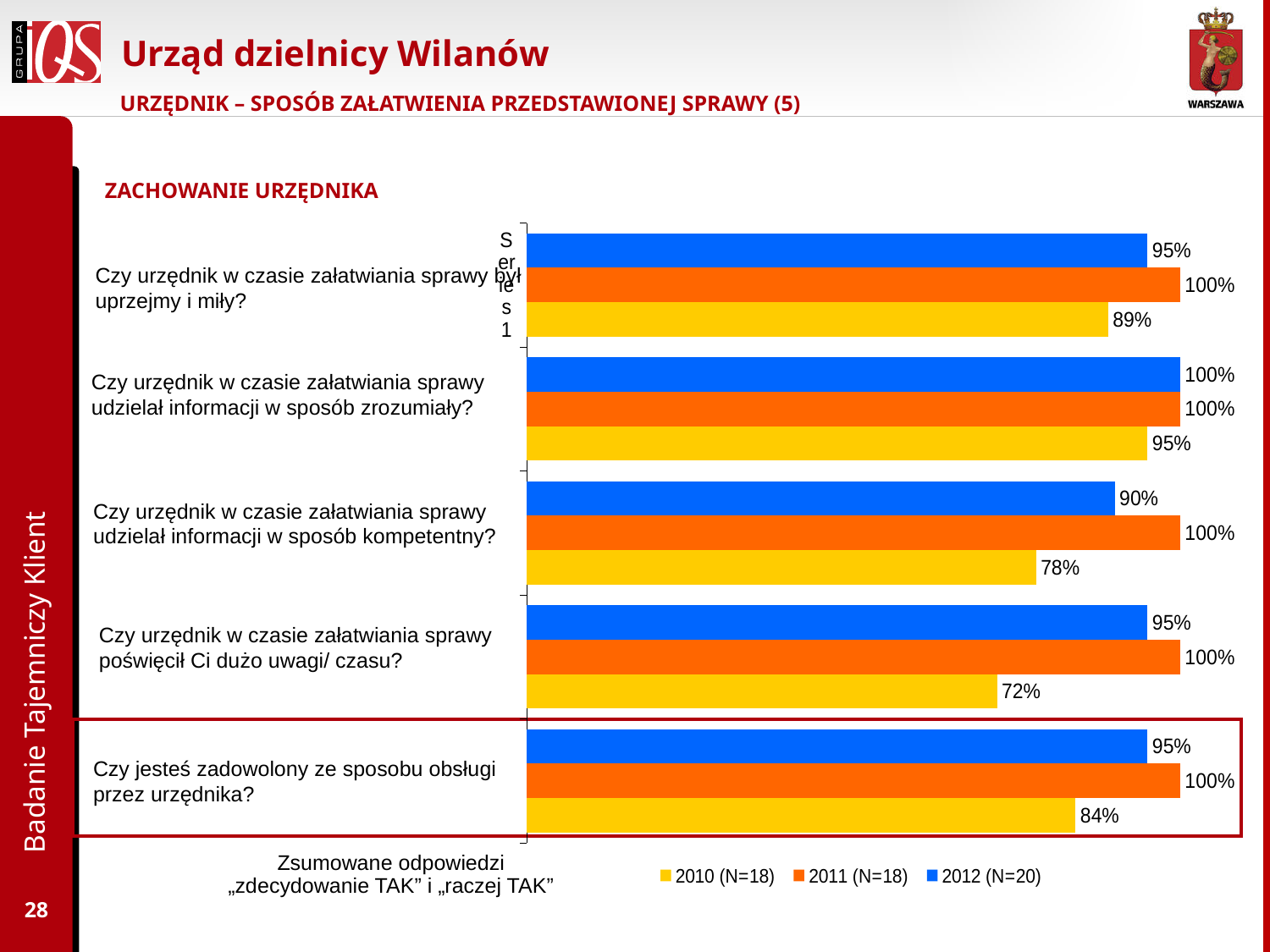
What type of chart is shown on the slide? bar chart What is the 2012 value for "Czy urzędnik w czasie załatwiania sprawy udzielał informacji w sposób kompetentny?"? 90% What is the 2010 value for "Czy jesteś zadowolony ze sposobu obsługi przez urzędnika?"? 84% What is the difference between the 2011 and 2010 values for "Czy urzędnik w czasie załatwiania sprawy udzielał informacji w sposób kompetentny?"? 22% What is the 2010 value for "Czy urzędnik w czasie załatwiania sprawy poświęcił Ci dużo uwagi/ czasu?"? 72% Which category has the highest 2012 value? Czy urzędnik w czasie załatwiania sprawy udzielał informacji w sposób zrozumiały? How many series does the legend list? 3 What is the sample size (N) shown in the legend for 2012? N=20 How many question categories are plotted on the chart? 5 Which category has the lowest 2010 value? Czy urzędnik w czasie załatwiania sprawy poświęcił Ci dużo uwagi/ czasu? Which colour represents the 2011 series in the legend? orange For "Czy urzędnik w czasie załatwiania sprawy był uprzejmy i miły?", which is larger: the 2012 value or the 2010 value? 2012